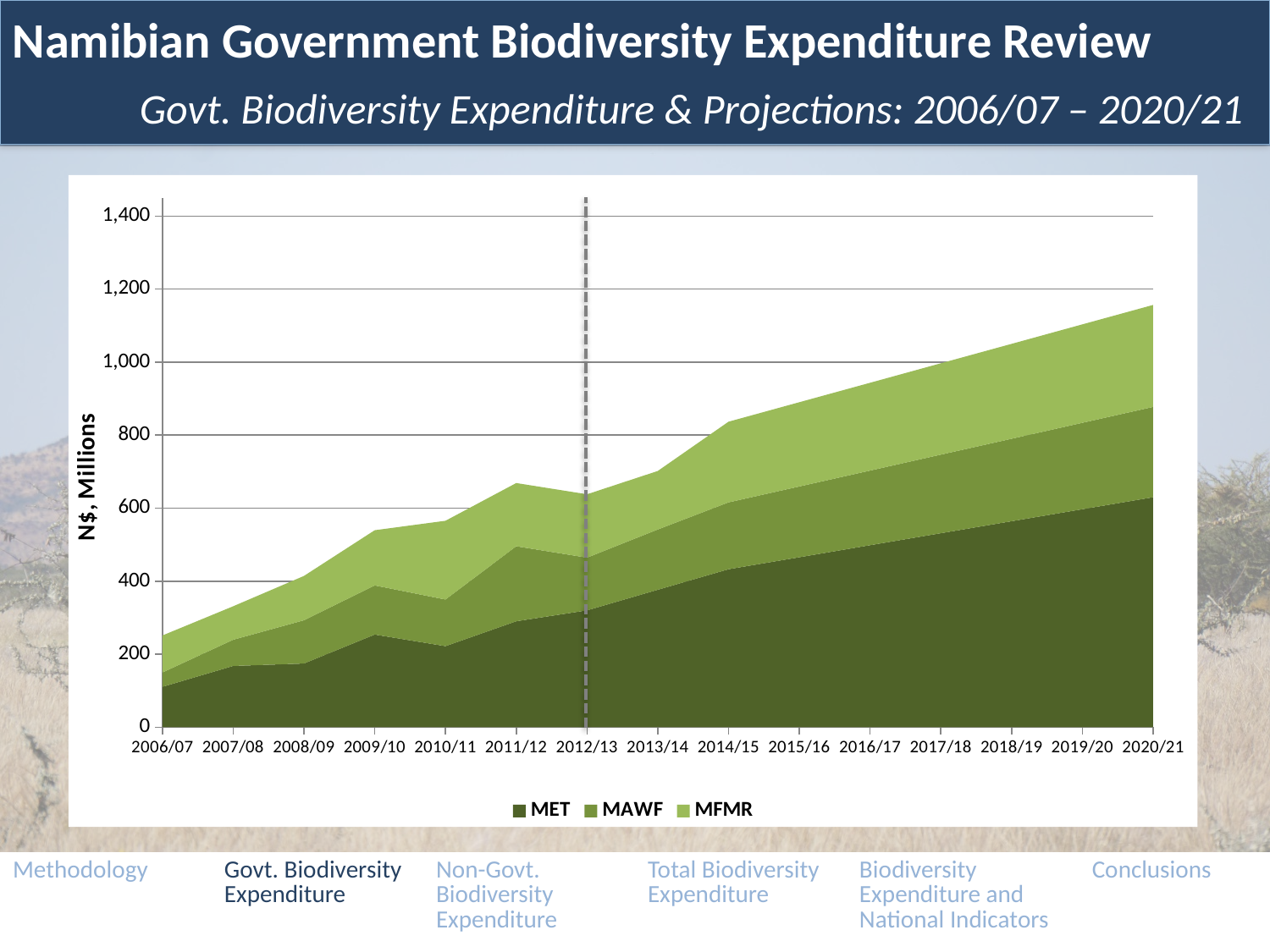
How many series does the legend list? 3 Which year has the larger total expenditure, 2010/11 or 2011/12? 2011/12 What kind of chart is shown on the slide? Stacked area chart Does total government biodiversity expenditure generally rise or fall from 2006/07 to 2020/21? Rise Which year has the highest total expenditure? 2020/21 Is the total expenditure for 2020/21 greater or less than 1,000? greater Is the total expenditure for 2012/13 greater or less than 800? less How many fiscal years are plotted along the x axis? 15 Which year has the lowest total expenditure? 2006/07 What is the label on the y axis? N$, Millions Which series are listed in the legend? MET, MAWF, MFMR Is the MET value for 2006/07 greater or less than 200? less